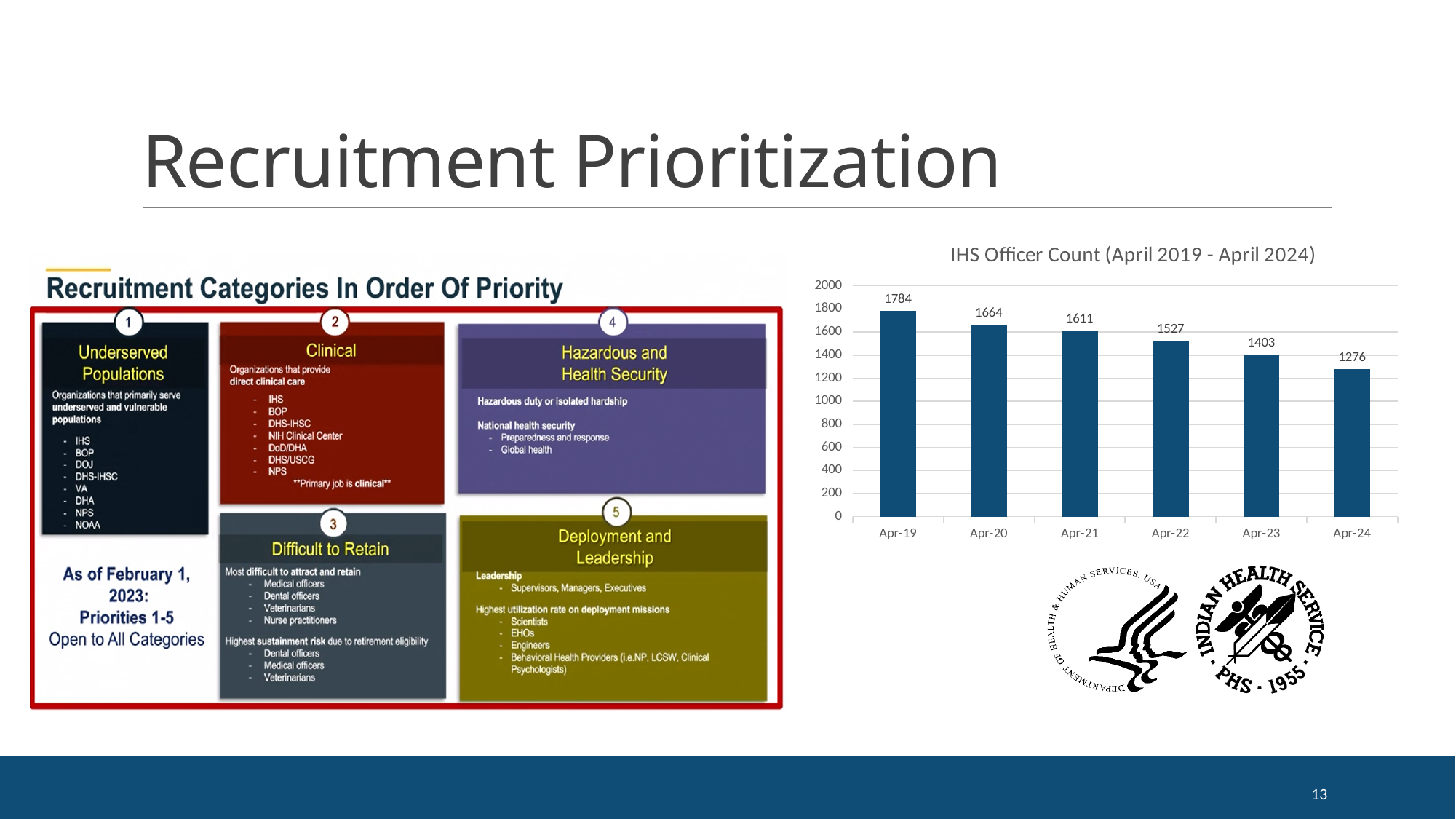
Is the IHS officer count for Apr-23 greater or less than 1600? less Which is larger, the IHS officer count for Apr-21 or Apr-23? Apr-21 What is the difference in IHS officer count between Apr-19 and Apr-24? 508 What is the difference in IHS officer count between Apr-20 and Apr-21? 53 What kind of chart is the IHS Officer Count chart? bar chart What is the IHS officer count for Apr-22? 1527 How many months are shown on the x axis of the IHS Officer Count chart? 6 Which month has the highest IHS officer count? Apr-19 Does the IHS officer count rise or fall from Apr-19 to Apr-24? fall What is the IHS officer count for Apr-24? 1276 Which month has the lowest IHS officer count? Apr-24 What is the IHS officer count for Apr-19? 1784